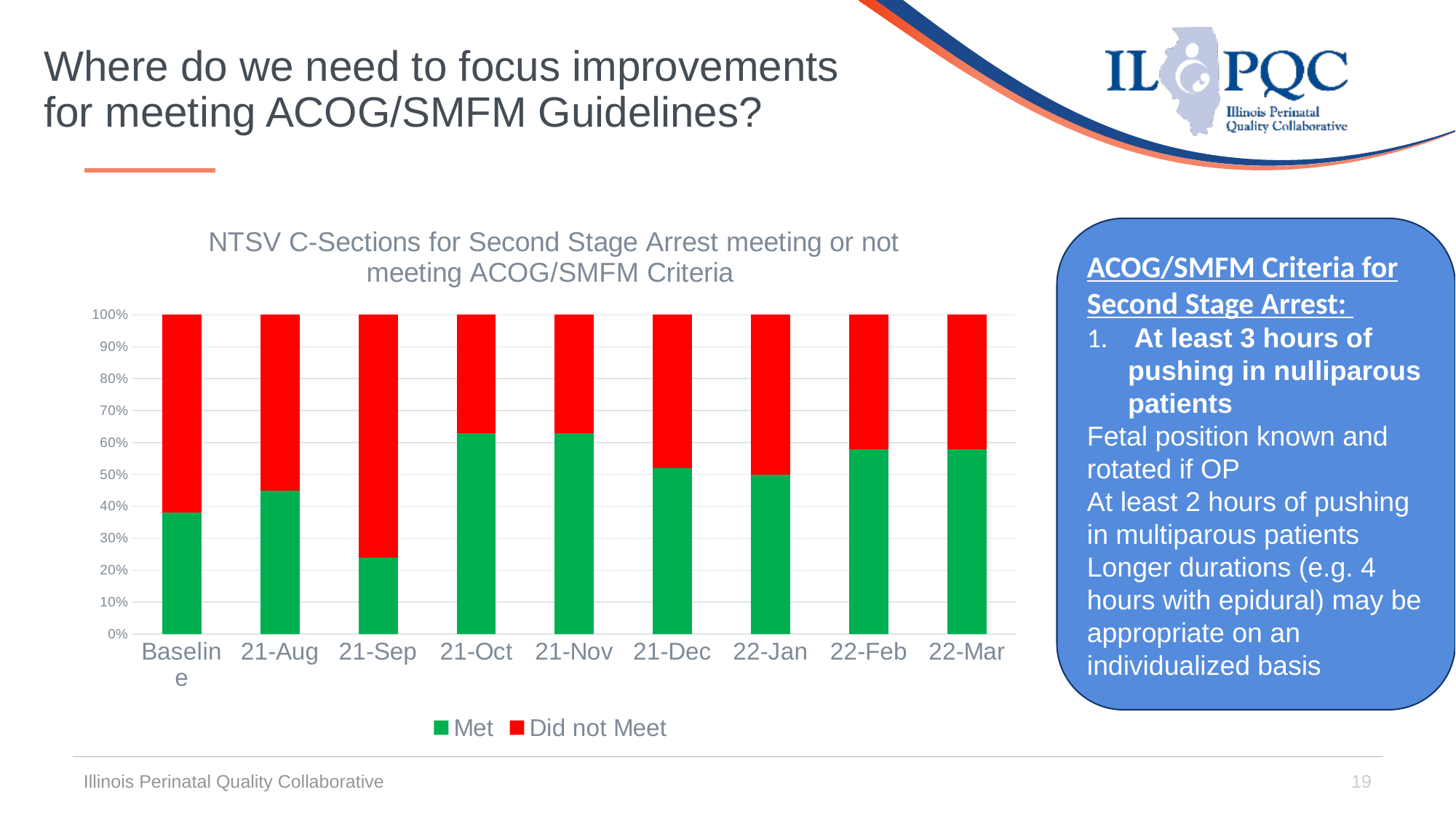
How many series does the chart legend list? 2 Which category has the lowest 'Met' share? 21-Sep Is the 'Met' value for 21-Oct greater or less than 60%? greater Is the 'Met' value for Baseline greater or less than 50%? less Which category has the largest 'Did not Meet' share? 21-Sep What kind of chart is shown on the slide? Stacked bar chart Is the 'Met' value for 21-Sep greater or less than 30%? less What colour represents the 'Did not Meet' series in the chart? Red How many categories are shown along the x axis of the chart? 9 Which has a larger 'Met' share, Baseline or 22-Mar? 22-Mar Which has a larger 'Met' share, 21-Sep or 21-Oct? 21-Oct